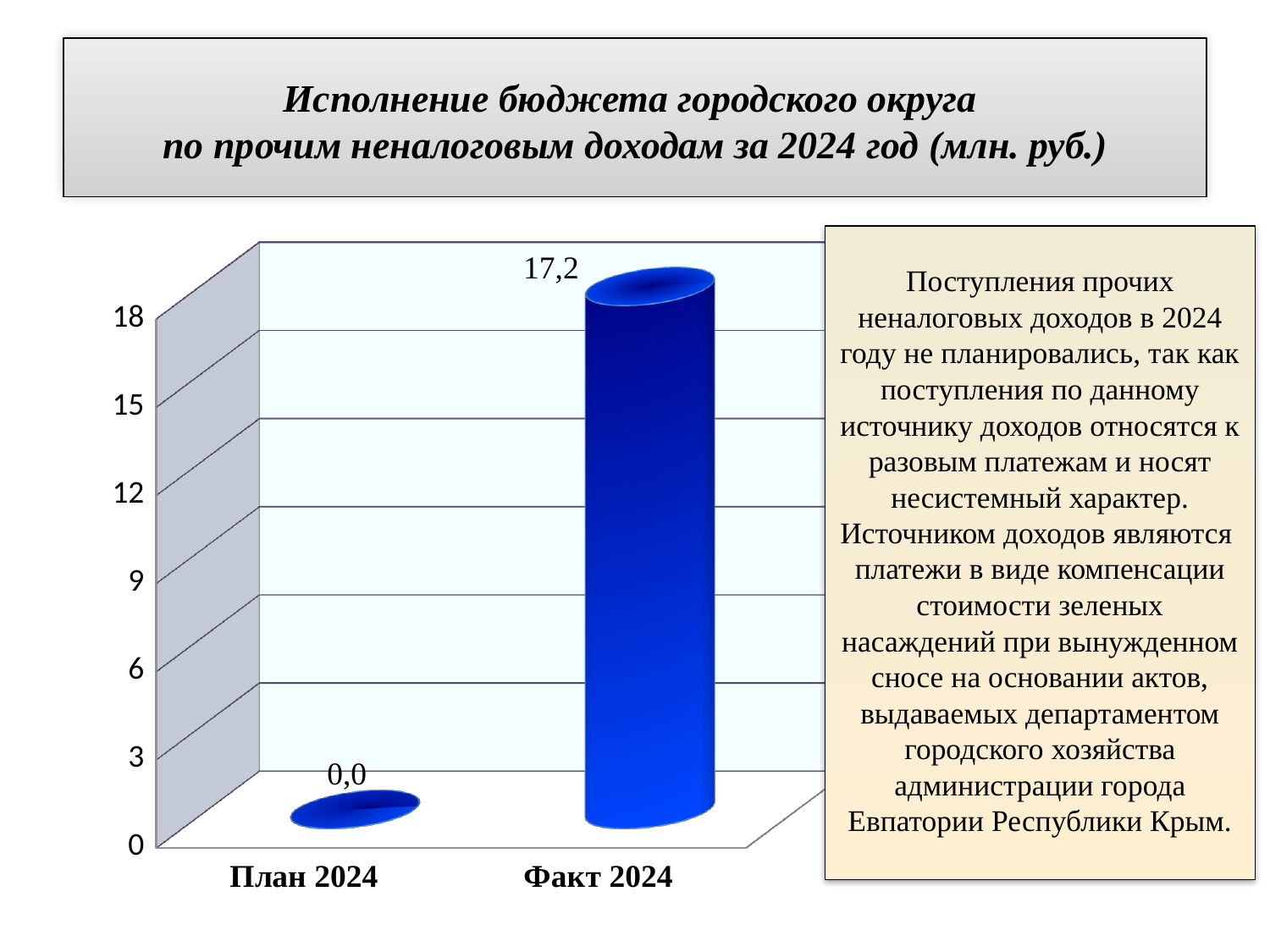
What is the value for Факт 2024? 17,2 Is the value for План 2024 greater or less than 3? less How many categories are shown on the x axis? 2 Which category has the lowest value? План 2024 What is the highest value shown on the vertical axis? 18 What is the difference between the values for Факт 2024 and План 2024? 17,2 Is the value for Факт 2024 greater or less than 15? greater What is the value for План 2024? 0,0 Which is larger, the value for План 2024 or the value for Факт 2024? Факт 2024 What kind of chart is shown on the slide? bar chart Do the values rise or fall from План 2024 to Факт 2024? rise Which category has the highest value? Факт 2024